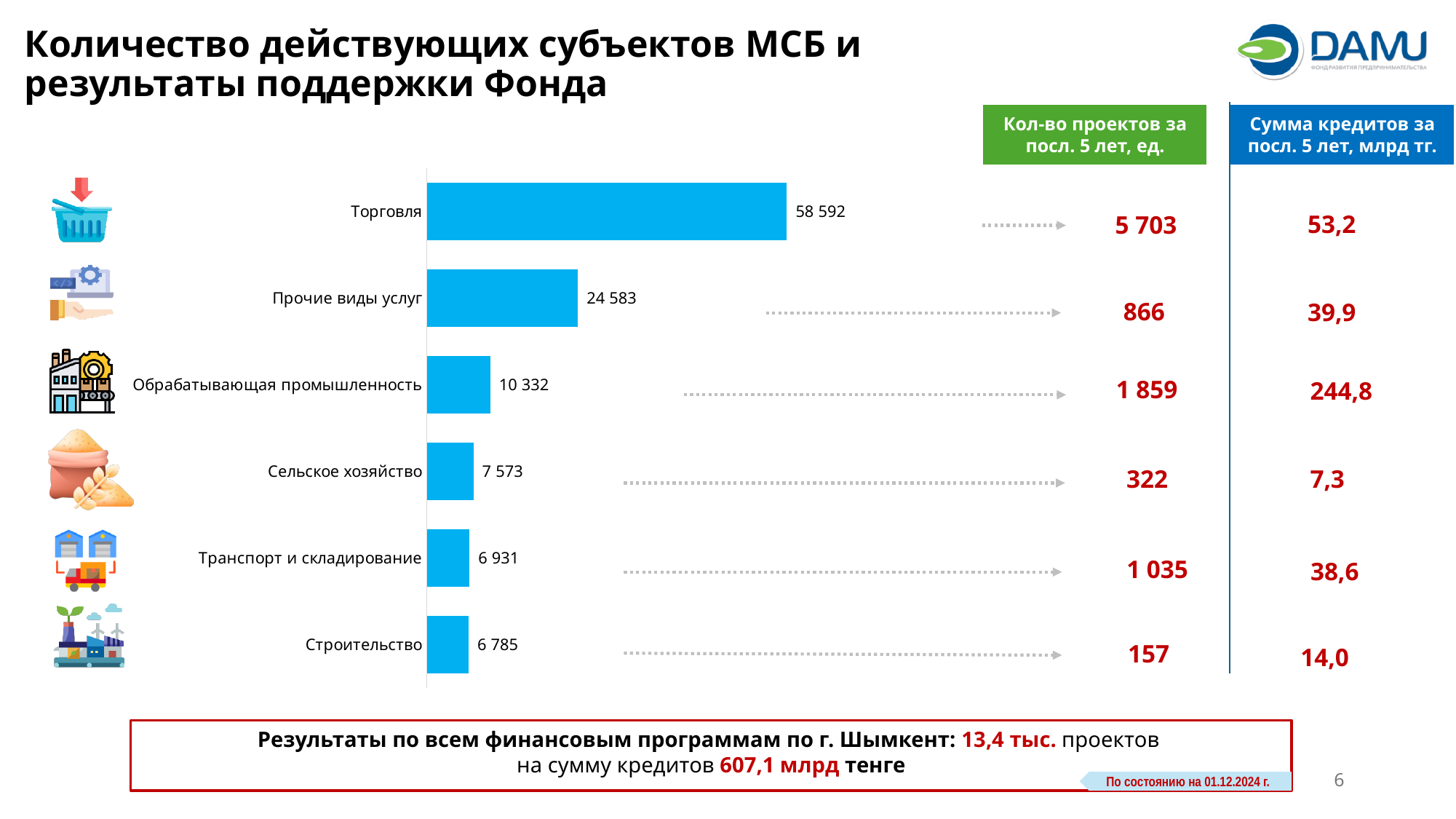
What is the value for Торговля in the bar chart? 58 592 What is the difference between the values for Торговля and Прочие виды услуг? 34 009 What is the value for Обрабатывающая промышленность in the bar chart? 10 332 Which is larger in the bar chart: Сельское хозяйство or Транспорт и складирование? Сельское хозяйство What is the value for Прочие виды услуг in the bar chart? 24 583 What is the title of the slide containing the bar chart? Количество действующих субъектов МСБ и результаты поддержки Фонда What kind of chart is shown on the slide? Bar chart What is the value for Строительство in the bar chart? 6 785 What is the value for Сельское хозяйство in the bar chart? 7 573 How many categories does the bar chart show? 6 Which category has the lowest value in the bar chart? Строительство Which category has the highest value in the bar chart? Торговля